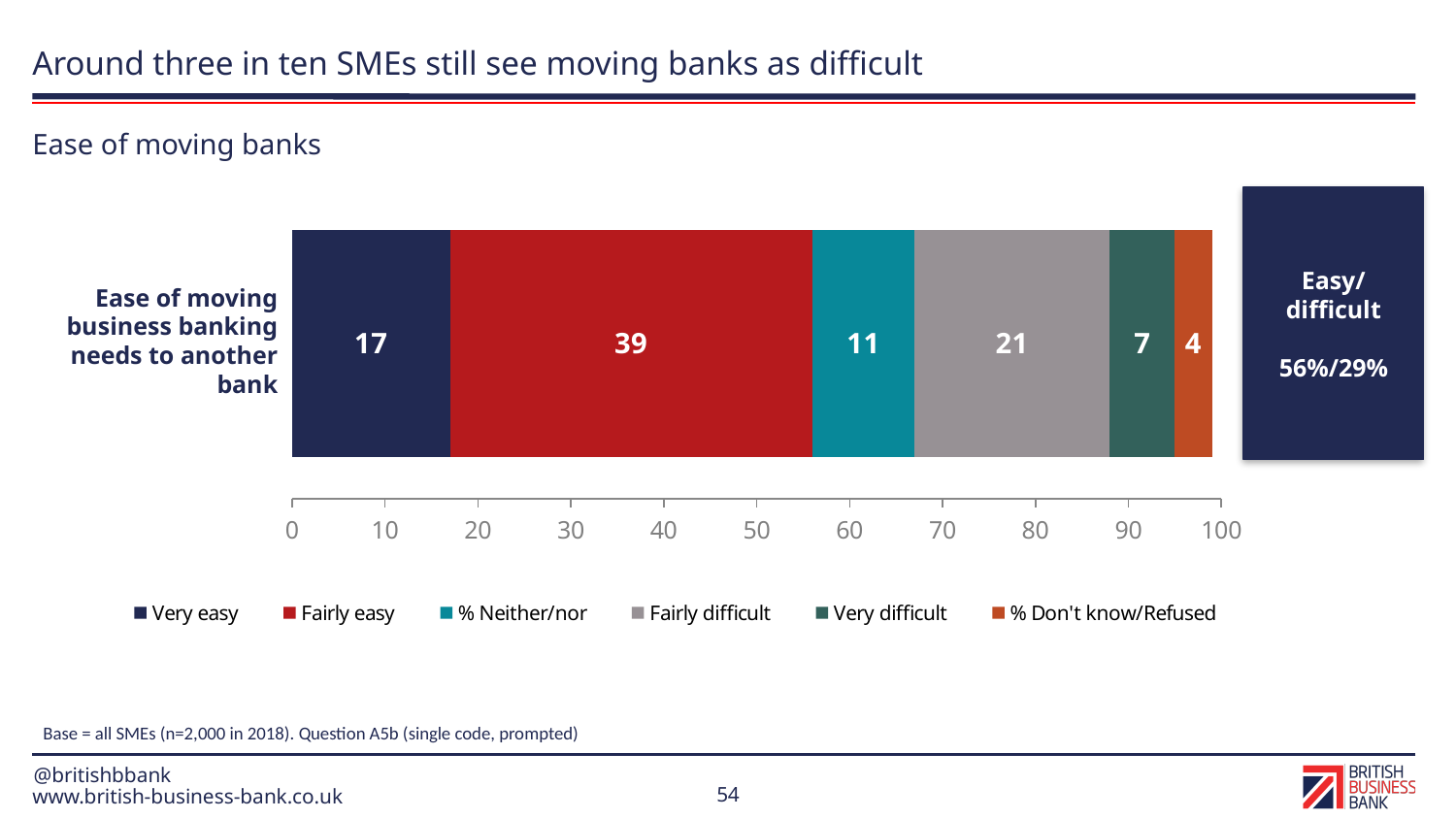
What is the value for Fairly difficult? 21 What is the value for Very difficult? 7 Which is larger, the value for Very easy or the value for % Neither/nor? Very easy Which series has the smallest segment in the bar? % Don't know/Refused How many series does the legend list? 6 What is the value for Fairly easy? 39 What is the difference between the Fairly easy and Fairly difficult values? 18 What is the value for % Don't know/Refused? 4 Which series has the largest segment in the bar? Fairly easy What is the value for Very easy? 17 What kind of chart is shown on the slide? Stacked bar chart What is the total of the stacked bar? 99